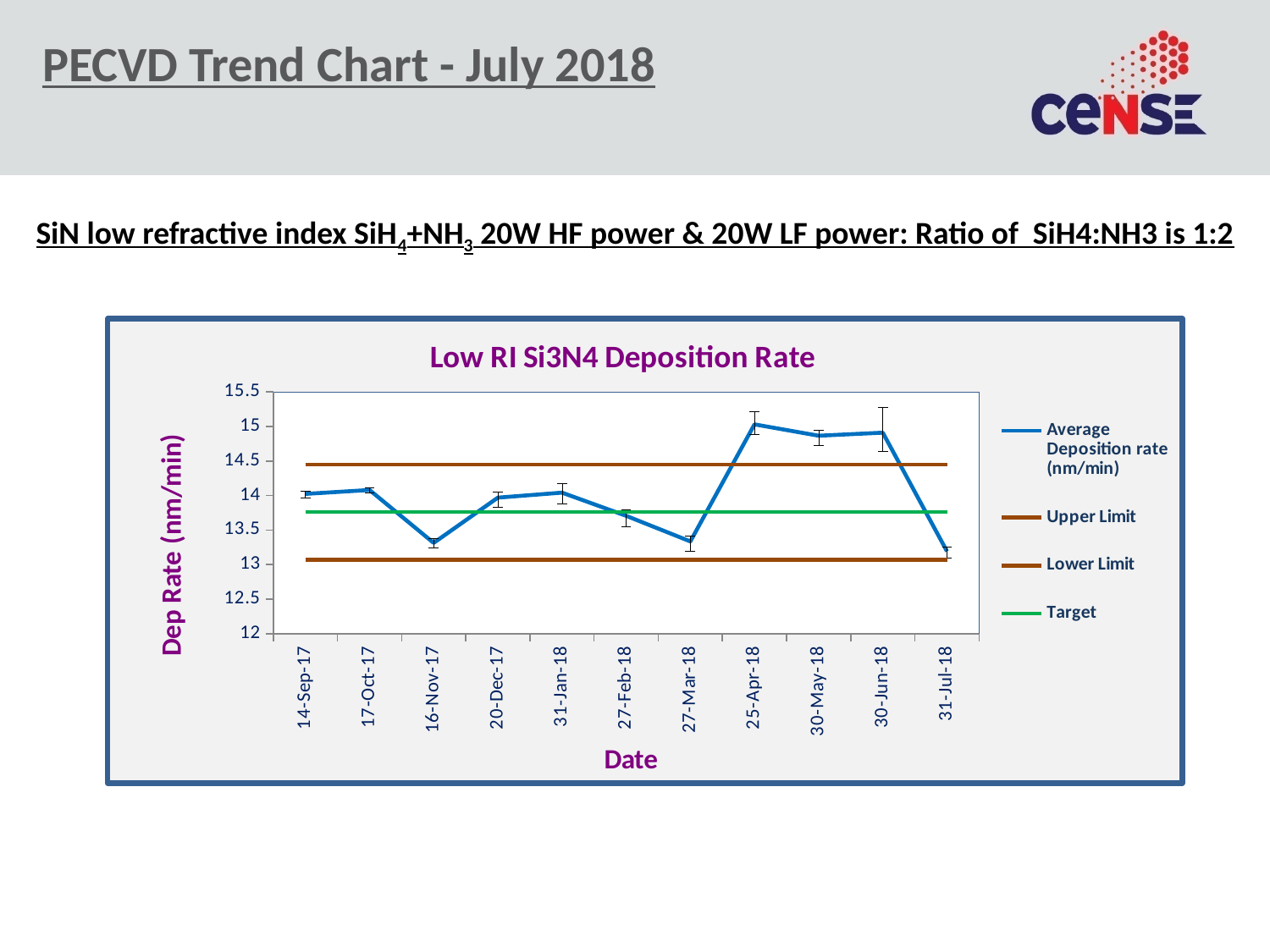
Is the Average Deposition rate for 14-Sep-17 greater or less than 13.5? greater Does the Average Deposition rate rise or fall from 30-Jun-18 to 31-Jul-18? fall How many series does the chart legend list? 4 Is the Average Deposition rate for 16-Nov-17 greater or less than 13.5? less Which has the higher Average Deposition rate, 25-Apr-18 or 16-Nov-17? 25-Apr-18 How many dates are plotted along the x axis? 11 What is the label of the y axis? Dep Rate (nm/min) Which has the higher Average Deposition rate, 14-Sep-17 or 31-Jul-18? 14-Sep-17 Is the Average Deposition rate for 31-Jul-18 greater or less than 13.5? less What is the title of the chart? Low RI Si3N4 Deposition Rate What kind of chart is shown on the slide? Line chart